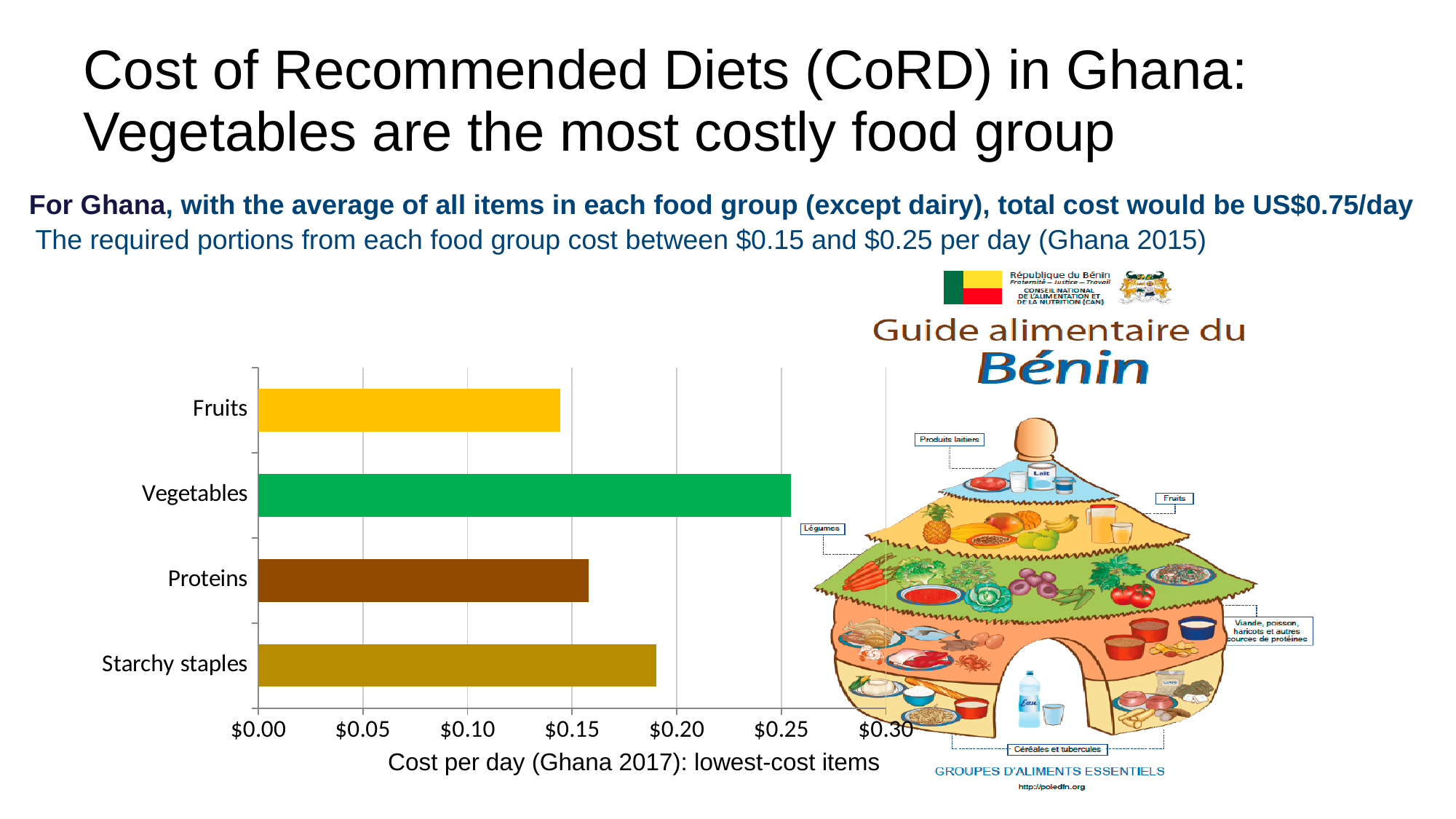
Which food group has the highest cost per day in the chart? Vegetables What is the title of the horizontal axis of the chart? Cost per day (Ghana 2017): lowest-cost items Which food group has the lowest cost per day in the chart? Fruits How many food groups are plotted in the chart? 4 Which has a higher cost per day, Starchy staples or Proteins? Starchy staples Is the value for Vegetables greater or less than $0.20? greater Which has a higher cost per day, Vegetables or Fruits? Vegetables Is the value for Fruits greater or less than $0.15? less What colour is the bar for Vegetables? Green Is the value for Starchy staples greater or less than $0.20? less What kind of chart is shown on the slide? Bar chart